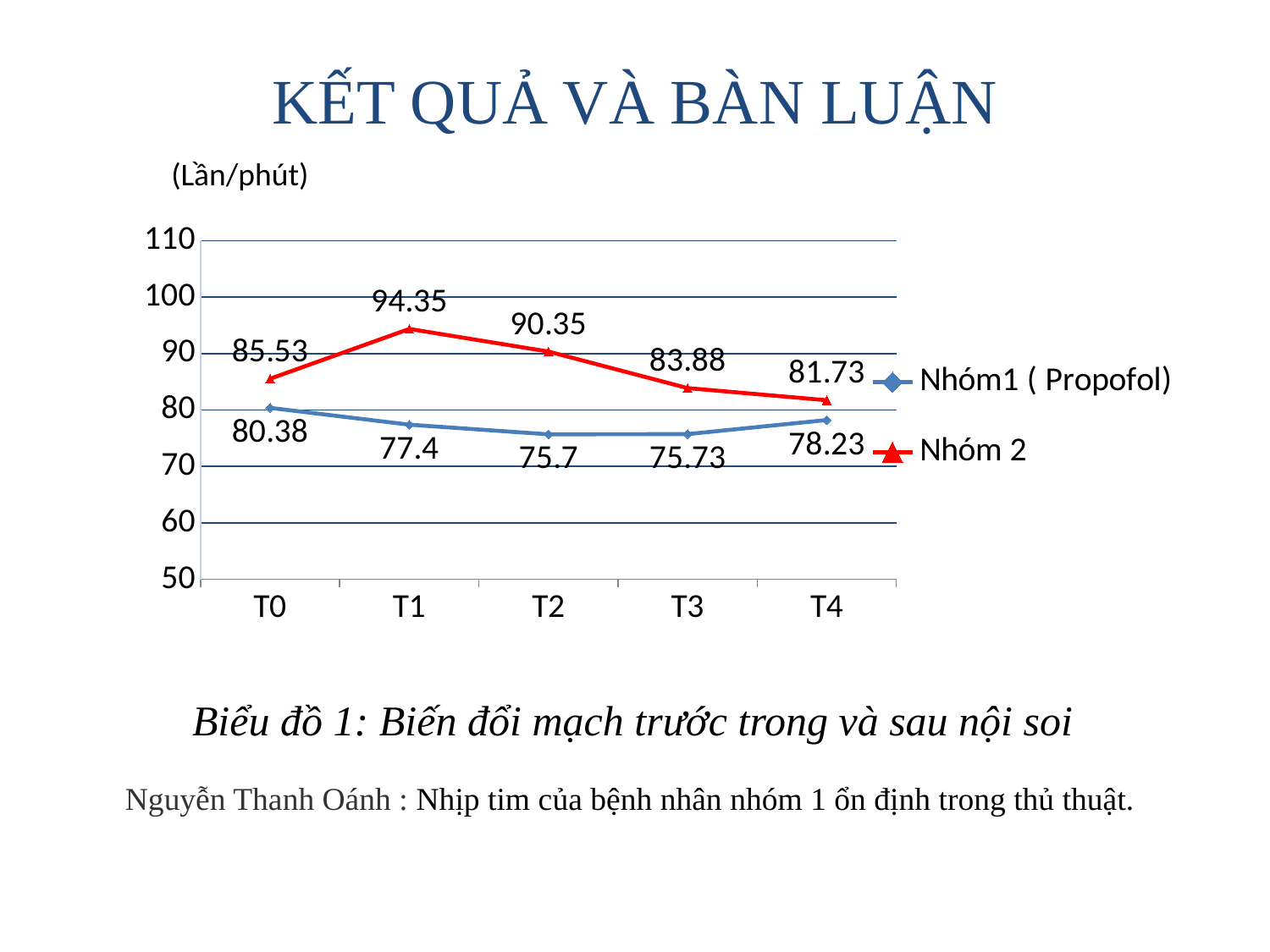
How many time points are plotted on the x axis? 5 At which time point is the value for Nhóm 2 highest? T1 What is the value for Nhóm1 ( Propofol) at T2? 75.7 What is the value for Nhóm1 ( Propofol) at T0? 80.38 What is the value for Nhóm 2 at T4? 81.73 Does the value for Nhóm 2 rise or fall from T1 to T4? Fall What is the value for Nhóm 2 at T1? 94.35 At which time point is the value for Nhóm1 ( Propofol) lowest? T2 Which series has the larger value at T3, Nhóm1 ( Propofol) or Nhóm 2? Nhóm 2 What kind of chart is shown on the slide? Line chart How many series does the legend list? 2 What is the difference between Nhóm 2 and Nhóm1 ( Propofol) at T1? 16.95